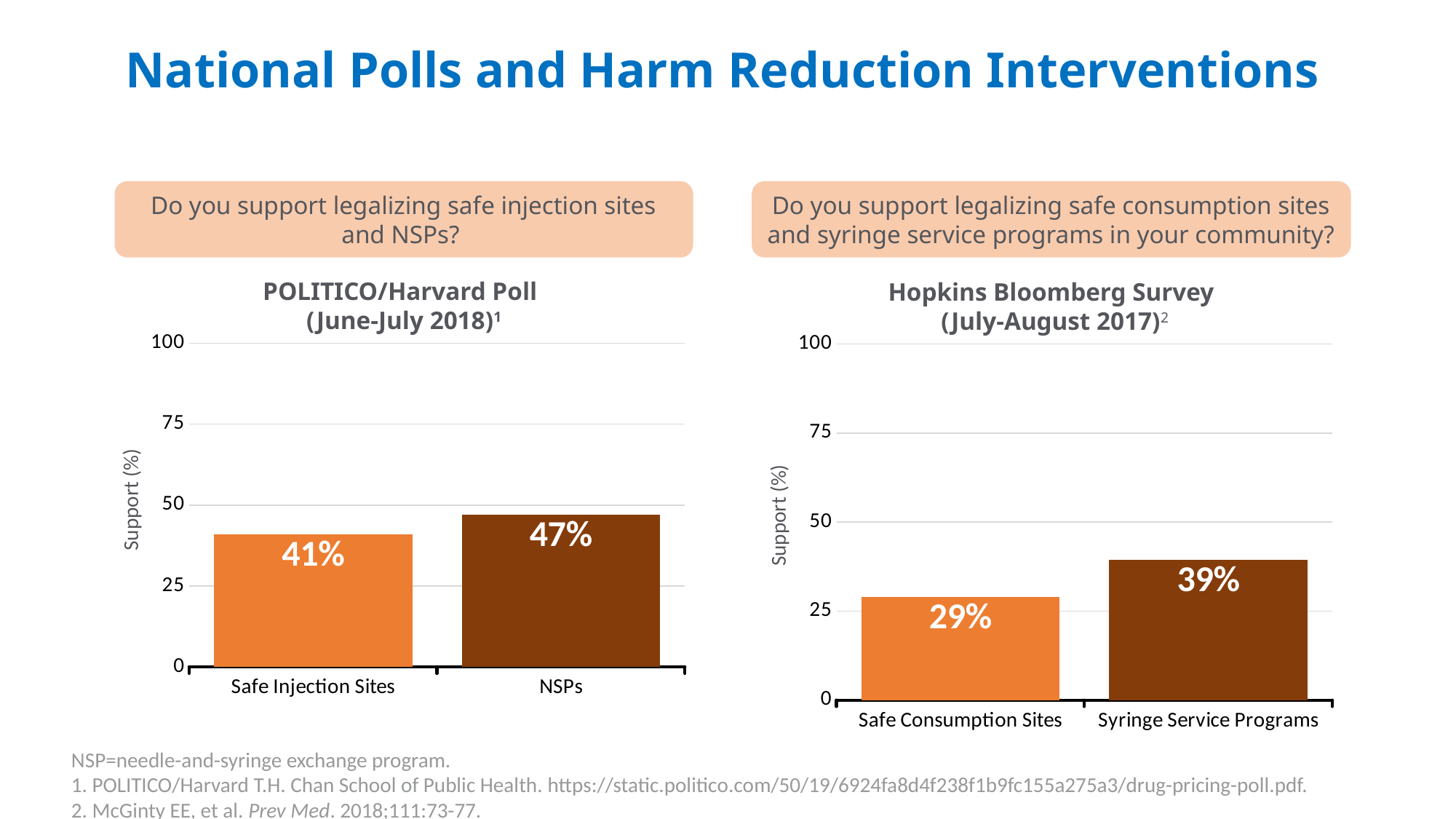
In the POLITICO/Harvard Poll chart, what is the support value for Safe Injection Sites? 41% In the Hopkins Bloomberg Survey chart, is the value for Safe Consumption Sites greater or less than 50? less In the POLITICO/Harvard Poll chart, what is the difference in support between NSPs and Safe Injection Sites? 6% In the POLITICO/Harvard Poll chart, which category has the highest support? NSPs What is the y-axis label on the POLITICO/Harvard Poll chart? Support (%) In the Hopkins Bloomberg Survey chart, what is the support value for Safe Consumption Sites? 29% In the Hopkins Bloomberg Survey chart, what is the difference in support between Syringe Service Programs and Safe Consumption Sites? 10% In the Hopkins Bloomberg Survey chart, what is the support value for Syringe Service Programs? 39% In the Hopkins Bloomberg Survey chart, which category has the lowest support? Safe Consumption Sites In the POLITICO/Harvard Poll chart, what is the support value for NSPs? 47% How many categories are shown in the POLITICO/Harvard Poll chart? 2 What kind of chart is the Hopkins Bloomberg Survey chart? Bar chart